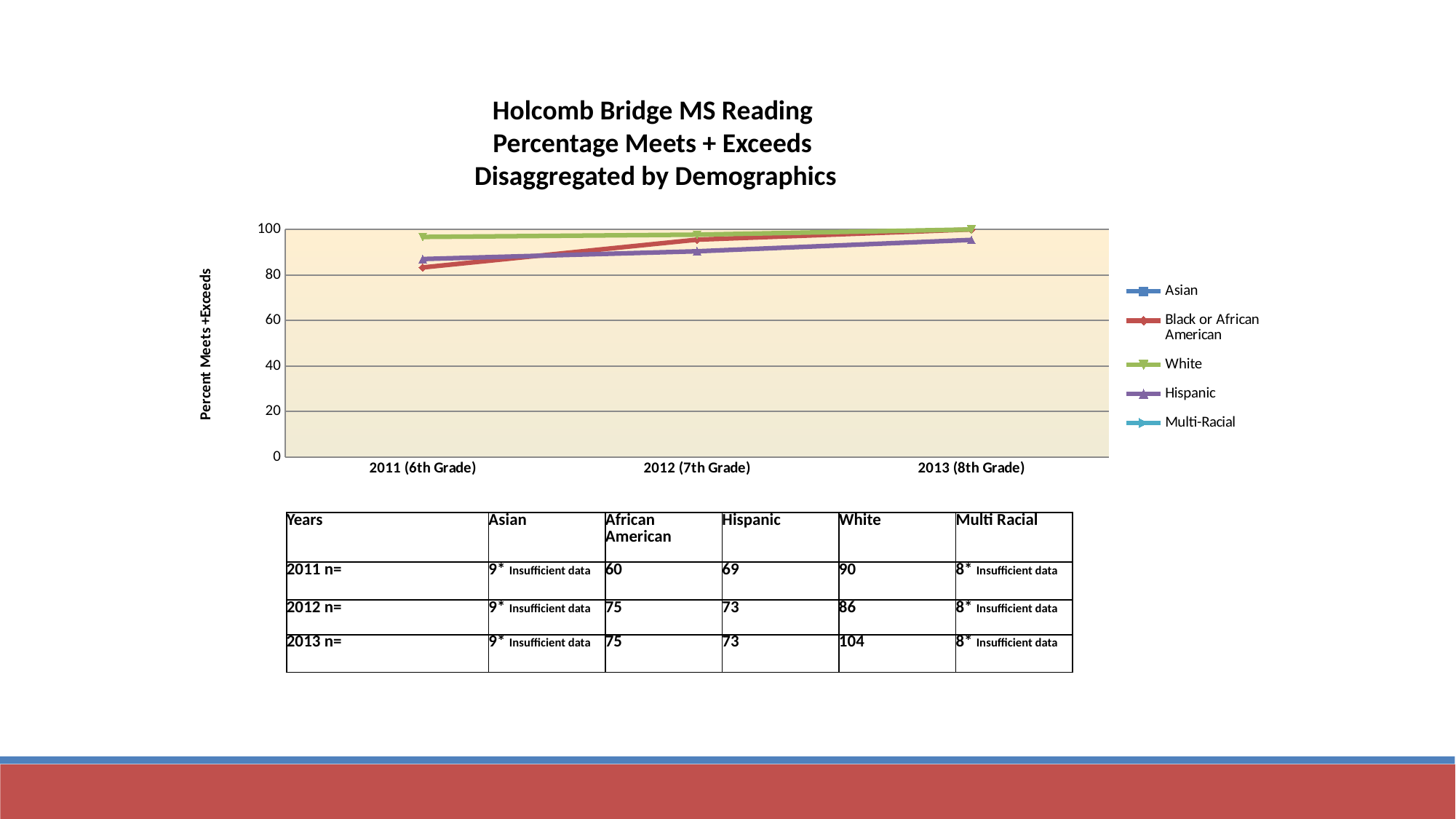
Is the value for Black or African American at 2011 (6th Grade) greater or less than 60? greater Does the value for Black or African American rise or fall from 2011 (6th Grade) to 2013 (8th Grade)? rise How many series does the chart's legend list? 5 What is the first line of the chart's title? Holcomb Bridge MS Reading Which series has the highest value at 2011 (6th Grade)? White What kind of chart is shown on the slide? line chart How many points are there along the x axis of the chart? 3 Is the value for Hispanic at 2011 (6th Grade) greater or less than 80? greater What is the label on the chart's vertical axis? Percent Meets +Exceeds Which series has the lowest value at 2013 (8th Grade)? Hispanic At 2013 (8th Grade), which is larger: the value for White or the value for Hispanic? White Which series has the lowest value at 2011 (6th Grade)? Black or African American